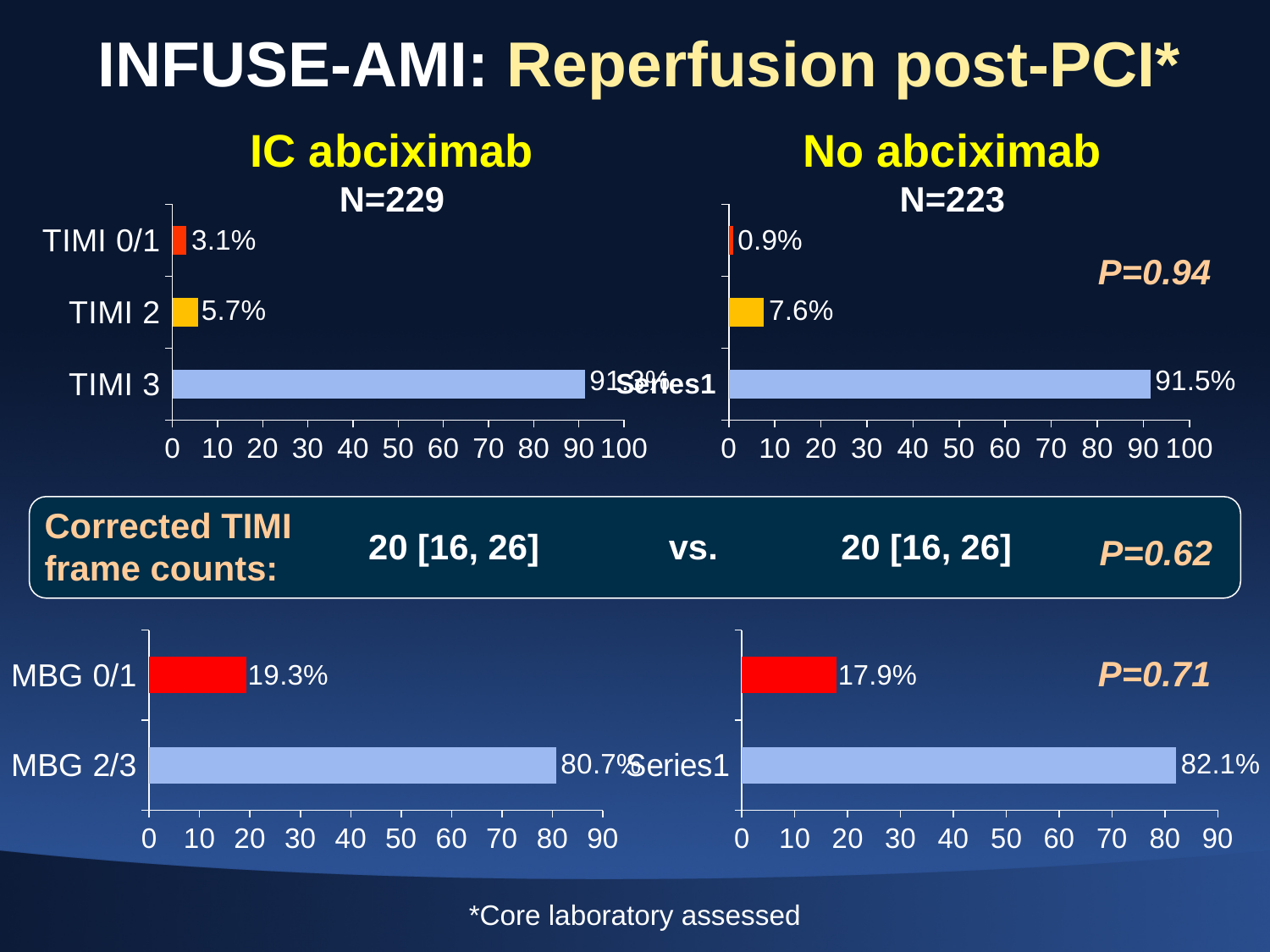
In the top-right chart (No abciximab, TIMI), which category has the lowest value? TIMI 0/1 In the bottom-right chart (No abciximab, MBG), which category has the highest value? MBG 2/3 In the top-left chart (IC abciximab, TIMI), what is the value for TIMI 0/1? 3.1% In the top-right chart (No abciximab, TIMI), what is the difference between the TIMI 2 and TIMI 0/1 values? 6.7% In the bottom-right chart (No abciximab, MBG), what is the value for MBG 0/1? 17.9% In the top-right chart (No abciximab, TIMI), what is the value for TIMI 0/1? 0.9% How many categories are shown in the bottom-left chart (IC abciximab, MBG)? 2 In the top-left chart (IC abciximab, TIMI), what is the value for TIMI 2? 5.7% In the top-right chart (No abciximab, TIMI), what is the value for TIMI 3? 91.5% In the top-left chart (IC abciximab, TIMI), is the value for TIMI 3 greater or less than 80? greater What kind of chart is the top-left chart (IC abciximab, TIMI)? Bar chart In the bottom-left chart (IC abciximab, MBG), what is the value for MBG 2/3? 80.7%